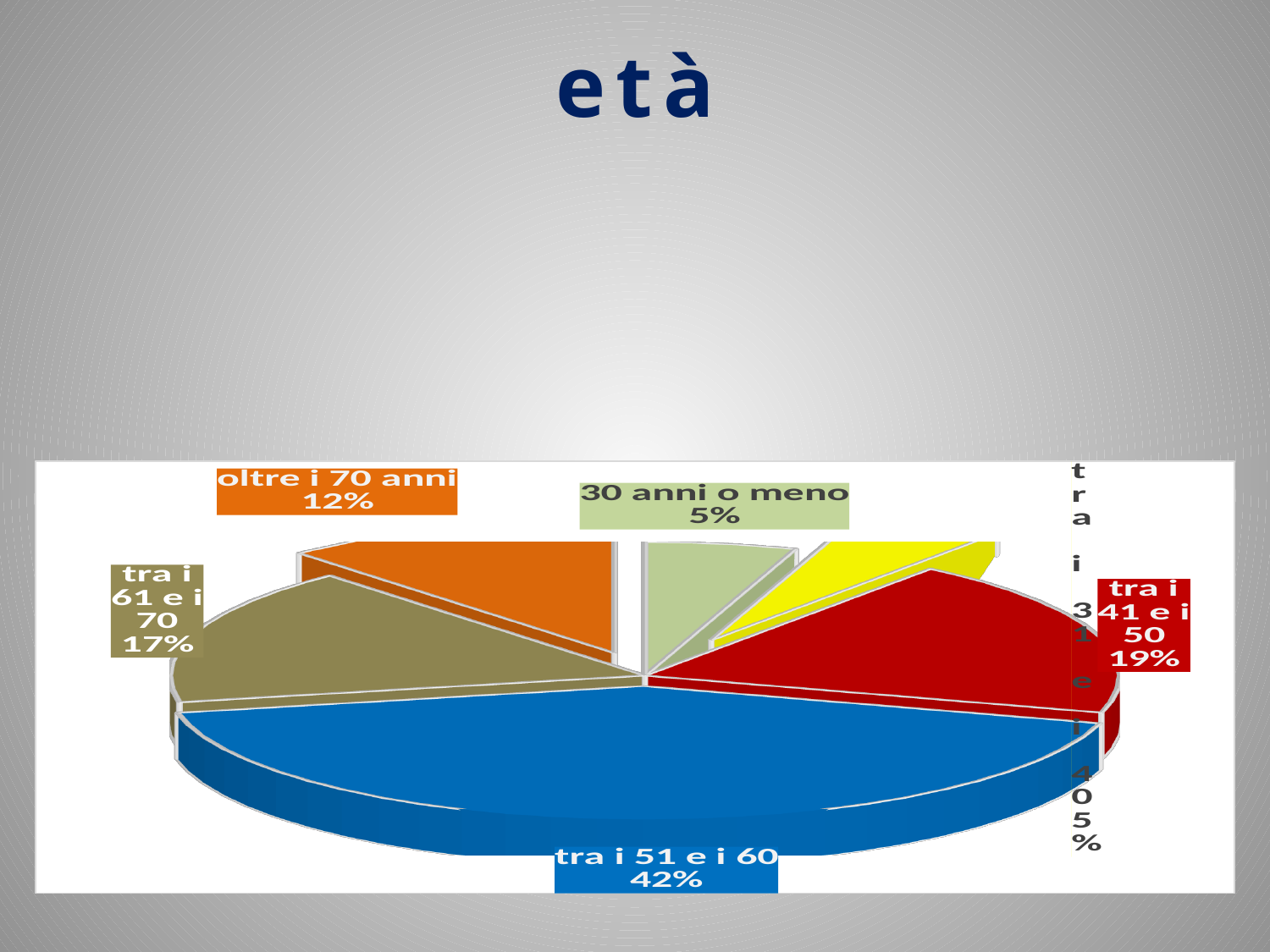
Which age group has the largest share of the pie? tra i 51 e i 60 What percentage is shown for the slice 'tra i 41 e i 50'? 19% What is the difference in percentage points between 'tra i 51 e i 60' and 'tra i 41 e i 50'? 23 What percentage is shown for the slice 'tra i 61 e i 70'? 17% What kind of chart is shown on the slide? pie chart How many slices does the pie chart have? 6 What percentage is shown for the slice 'oltre i 70 anni'? 12% What is the title of the chart? età What percentage is shown for the slice '30 anni o meno'? 5% What percentage is shown for the slice 'tra i 51 e i 60'? 42% What colour is the slice for 'tra i 51 e i 60'? blue Which slice is larger, 'tra i 61 e i 70' or 'oltre i 70 anni'? tra i 61 e i 70